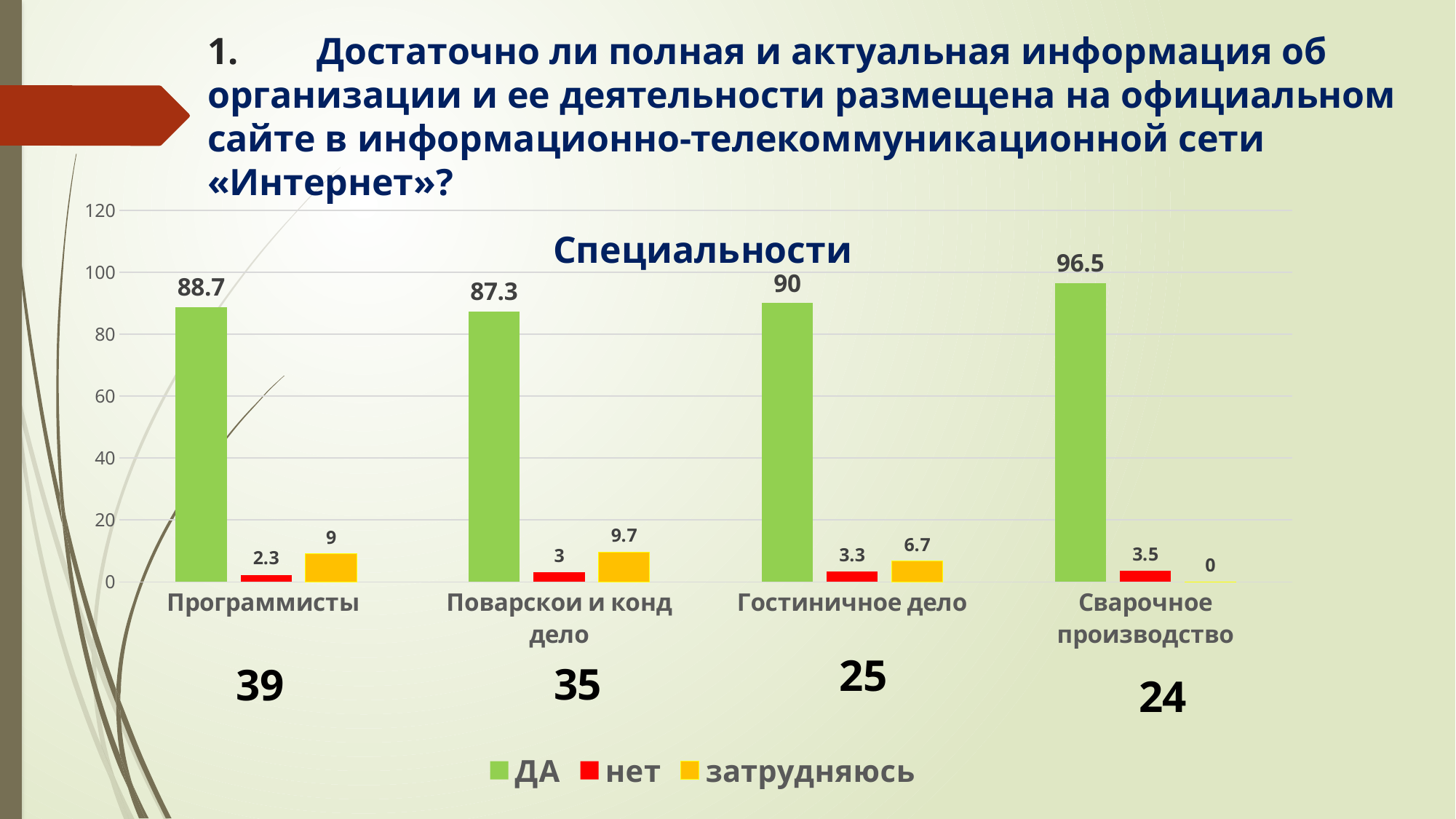
Which is larger: the затрудняюсь value for Программисты or for Гостиничное дело? Программисты What is the value of the нет series for Гостиничное дело? 3.3 What is the value of the затрудняюсь series for Поварской и конд дело? 9.7 How many categories are shown on the x axis of the chart? 4 Which category has the highest value in the ДА series? Сварочное производство What kind of chart is shown on the slide? Bar chart What is the value of the ДА series for Программисты? 88.7 Which category has the lowest value in the нет series? Программисты What is the difference between the ДА values for Сварочное производство and Поварской и конд дело? 9.2 What is the title of the chart? Специальности How many series does the legend list? 3 What is the value of the затрудняюсь series for Сварочное производство? 0